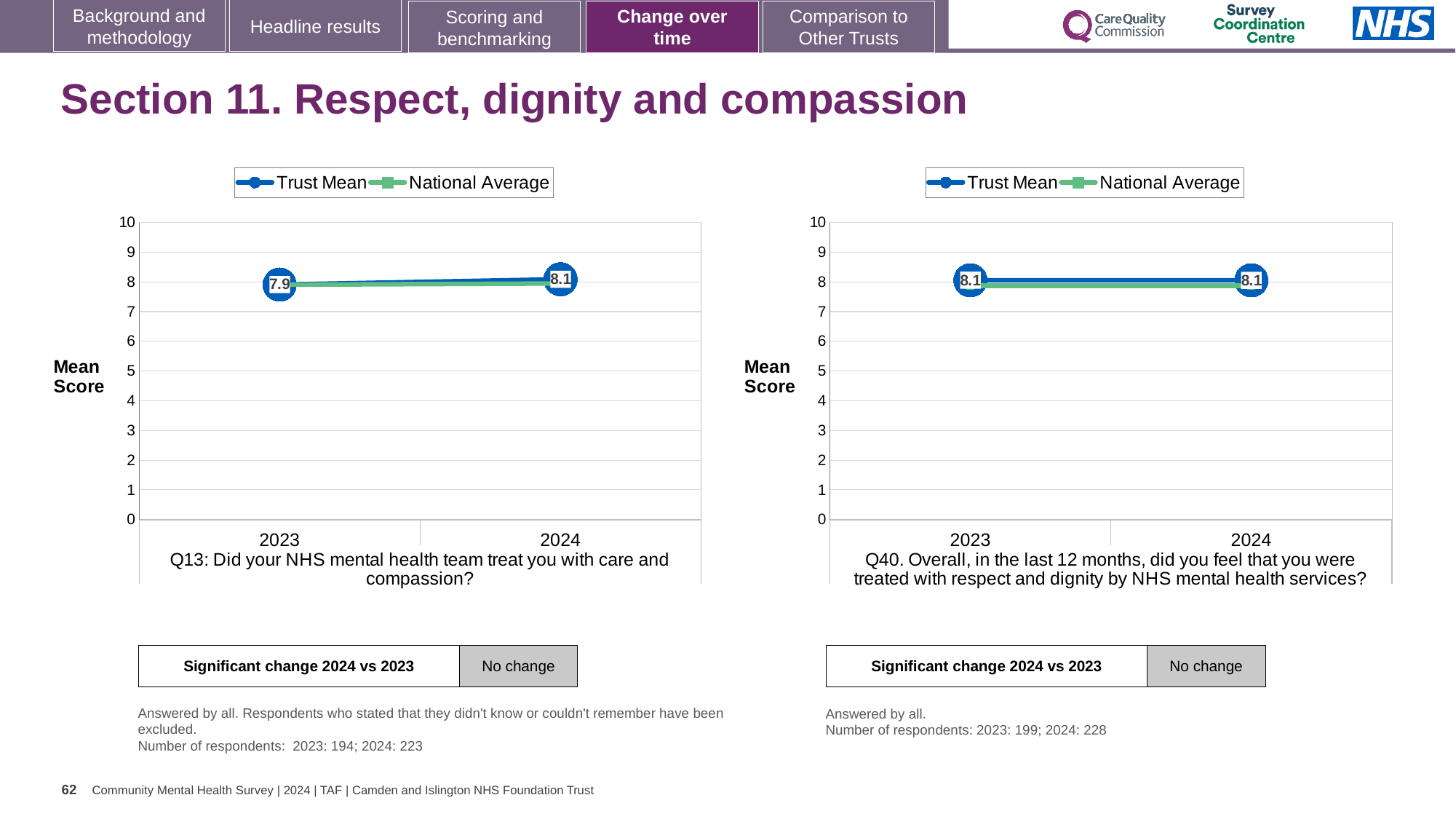
In the right chart (Q40), what is the Trust Mean for 2023? 8.1 How many years are plotted on the x axis of the left chart (Q13)? 2 In the left chart (Q13), what is the difference between the Trust Mean for 2024 and 2023? 0.2 In the left chart (Q13), which year has the higher Trust Mean? 2024 In the left chart (Q13), what is the Trust Mean for 2023? 7.9 In the right chart (Q40), what is the Trust Mean for 2024? 8.1 How many series does the legend of the right chart (Q40) list? 2 What is the label of the y axis on the right chart (Q40)? Mean Score In the right chart (Q40), is the Trust Mean for 2024 greater or less than 7? greater In the left chart (Q13), what is the Trust Mean for 2024? 8.1 In the left chart (Q13), does the Trust Mean rise or fall from 2023 to 2024? rise What kind of chart is the left chart (Q13)? line chart